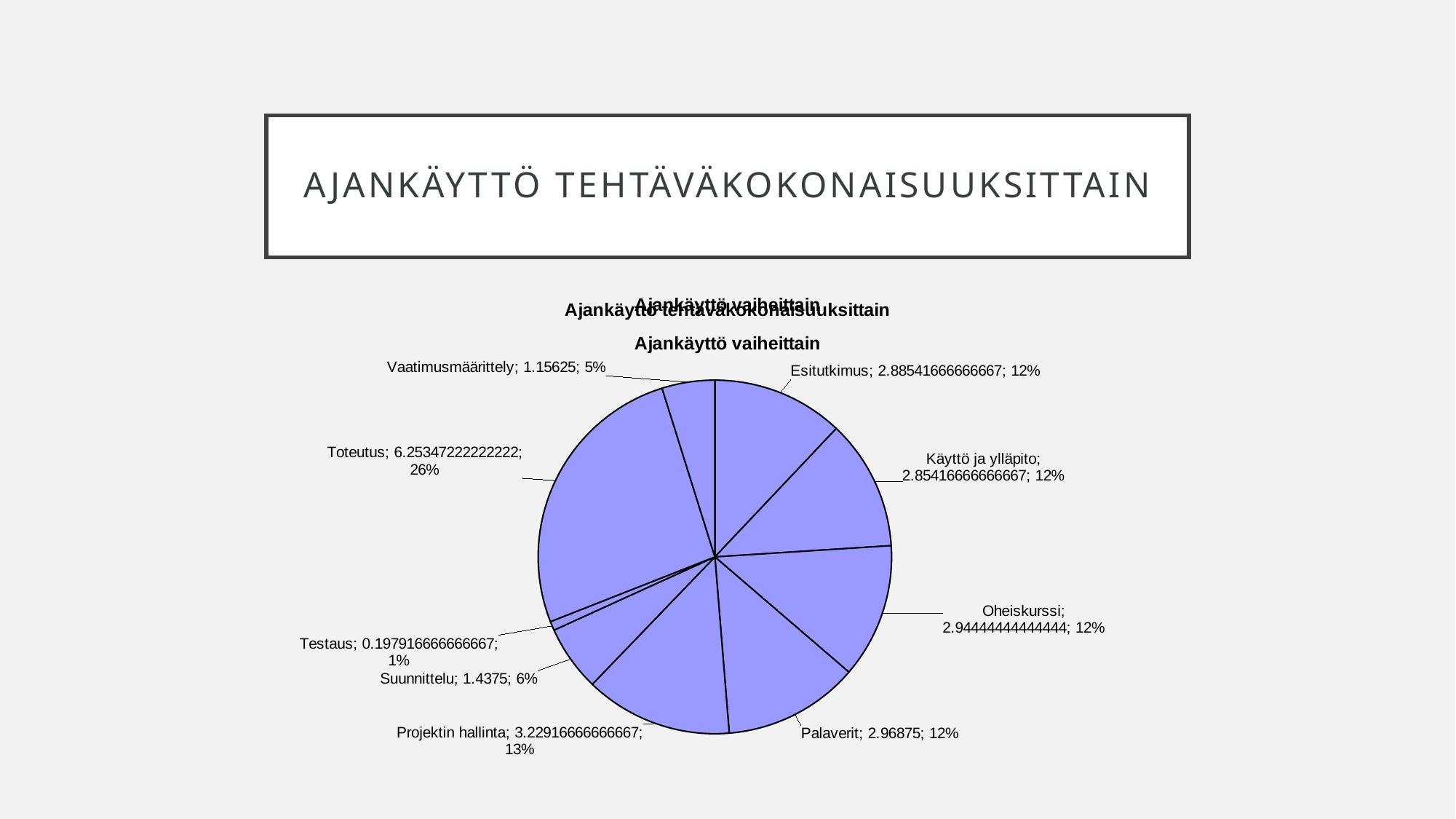
What percentage share of the pie does Toteutus have? 26% What percentage share of the pie does Suunnittelu have? 6% What kind of chart is shown on the slide? pie chart What is the value shown for Palaverit? 2.96875 What is the value shown for Projektin hallinta? 3.22916666666667 Which category has the smallest share of the pie? Testaus Which category has the largest share of the pie? Toteutus What is the difference in percentage share between Toteutus and Projektin hallinta? 13% What is the value shown for Testaus? 0.197916666666667 What is the value shown for Vaatimusmäärittely? 1.15625 How many slices does the pie chart have? 9 Which is larger, the value for Projektin hallinta or the value for Suunnittelu? Projektin hallinta